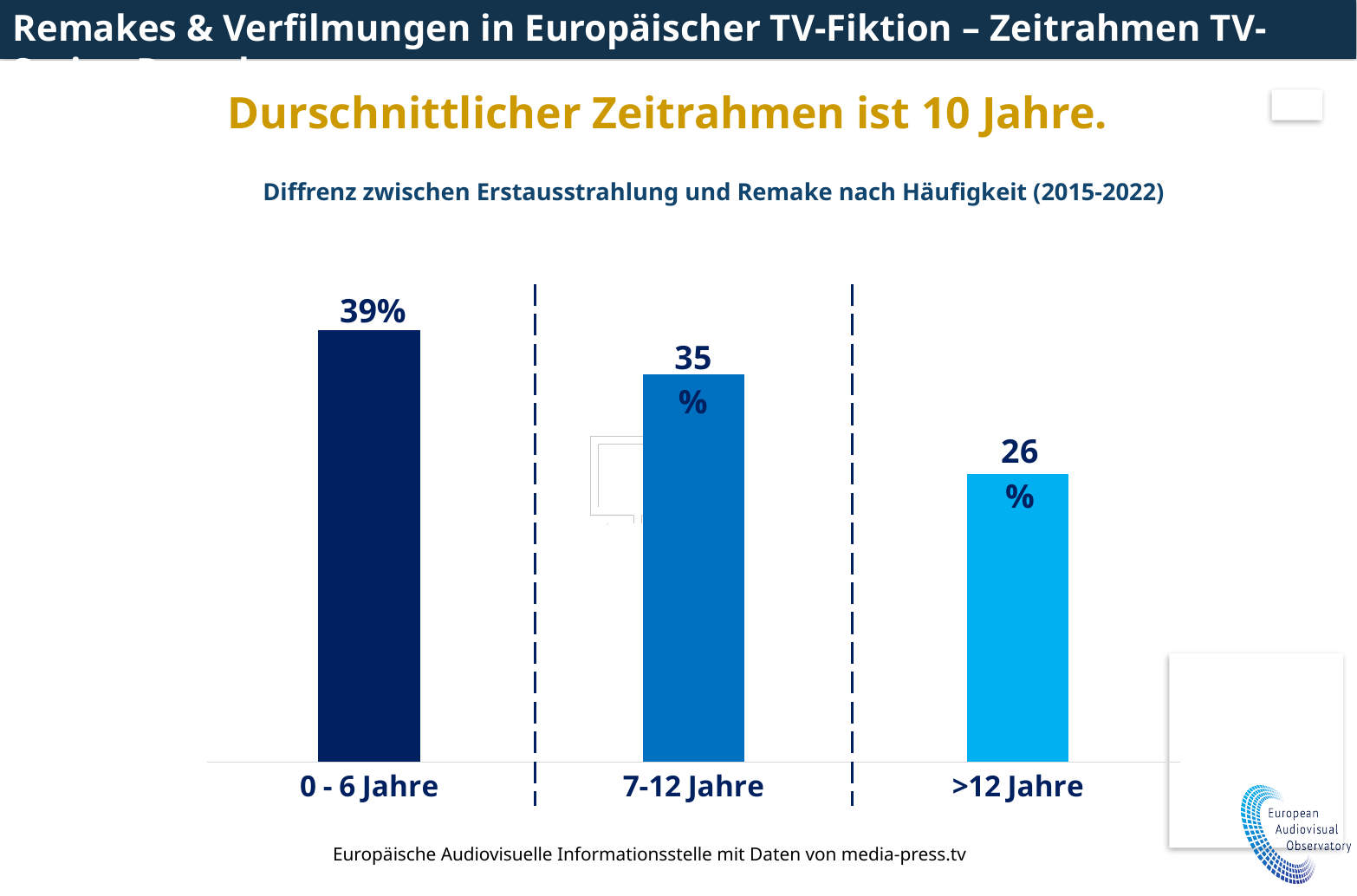
Which category has the lowest value? >12 Jahre What is the value for the 7-12 Jahre category? 35% What is the value for the >12 Jahre category? 26% How many categories are shown in the chart? 3 What is the value for the 0 - 6 Jahre category? 39% What is the difference between the values for 0 - 6 Jahre and 7-12 Jahre? 4% Which is larger, the value for 7-12 Jahre or the value for >12 Jahre? 7-12 Jahre What kind of chart is shown on the slide? Bar chart Which category has the highest value? 0 - 6 Jahre Do the values rise or fall from left to right across the categories? Fall What is the difference between the values for 0 - 6 Jahre and >12 Jahre? 13% What is the title of the chart? Diffrenz zwischen Erstausstrahlung und Remake nach Häufigkeit (2015-2022)